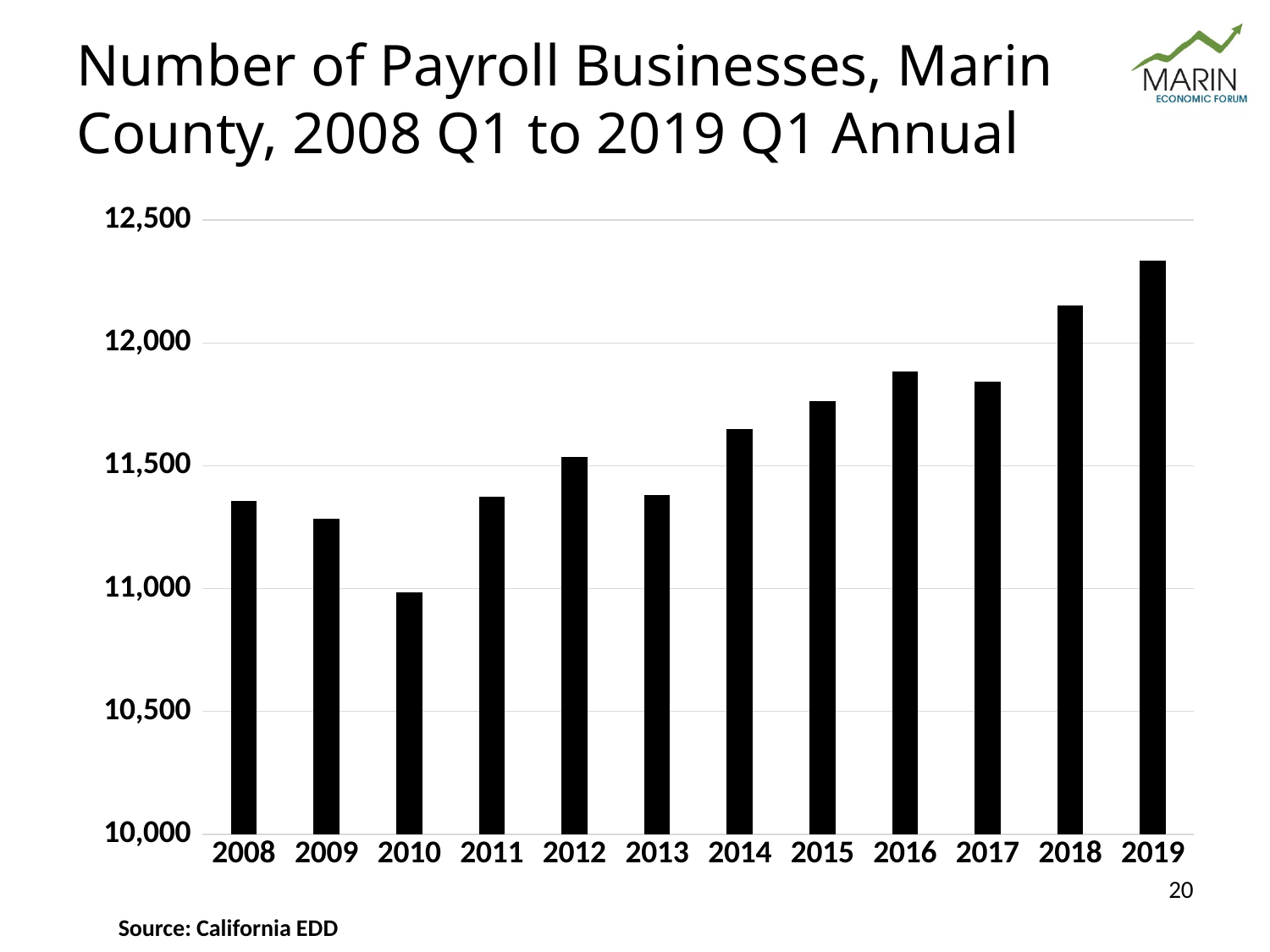
Is the value for 2014 greater or less than 11,500? greater Which year has the highest number of payroll businesses? 2019 Is the value for 2019 greater or less than 12,000? greater Is the value for 2017 greater or less than 12,000? less Which year has the lowest number of payroll businesses? 2010 What kind of chart is shown on the slide? bar chart How many years are plotted on the chart? 12 Overall, do the values rise or fall from 2010 to 2019? rise Which year has a larger value, 2018 or 2014? 2018 What source is cited for the chart data? California EDD